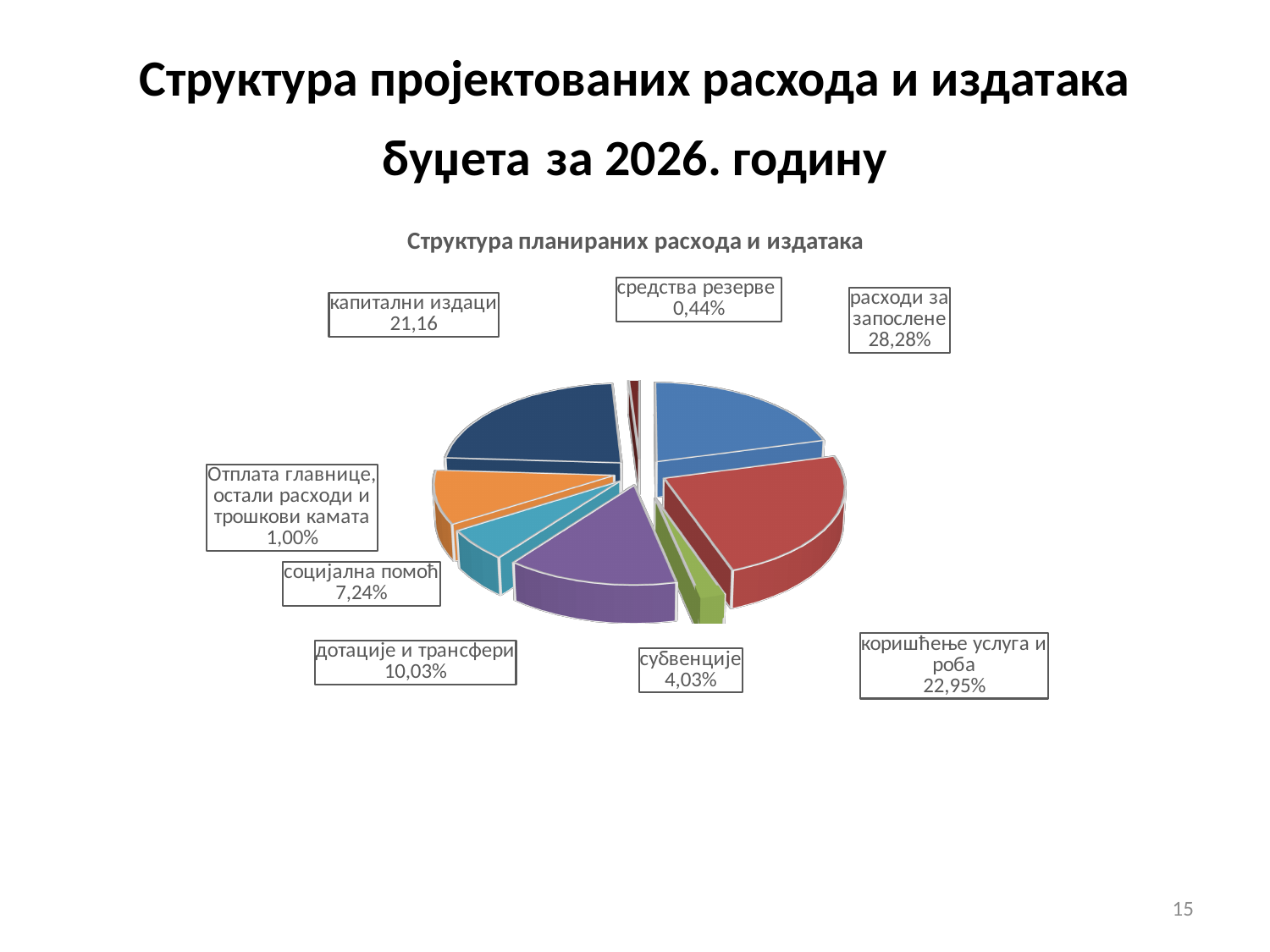
What is the value shown for коришћење услуга и роба? 22,95% What is the value shown for средства резерве? 0,44% What is the difference between the values for расходи за запослене and коришћење услуга и роба? 5,33% What is the title of the chart? Структура планираних расхода и издатака How many slices does the pie chart have? 8 Which is larger, социјална помоћ or субвенције? социјална помоћ What is the value shown for капитални издаци? 21,16 Which category has the smallest share of the pie? средства резерве What is the value shown for дотације и трансфери? 10,03% What kind of chart is shown on the slide? pie chart What is the value shown for расходи за запослене? 28,28%